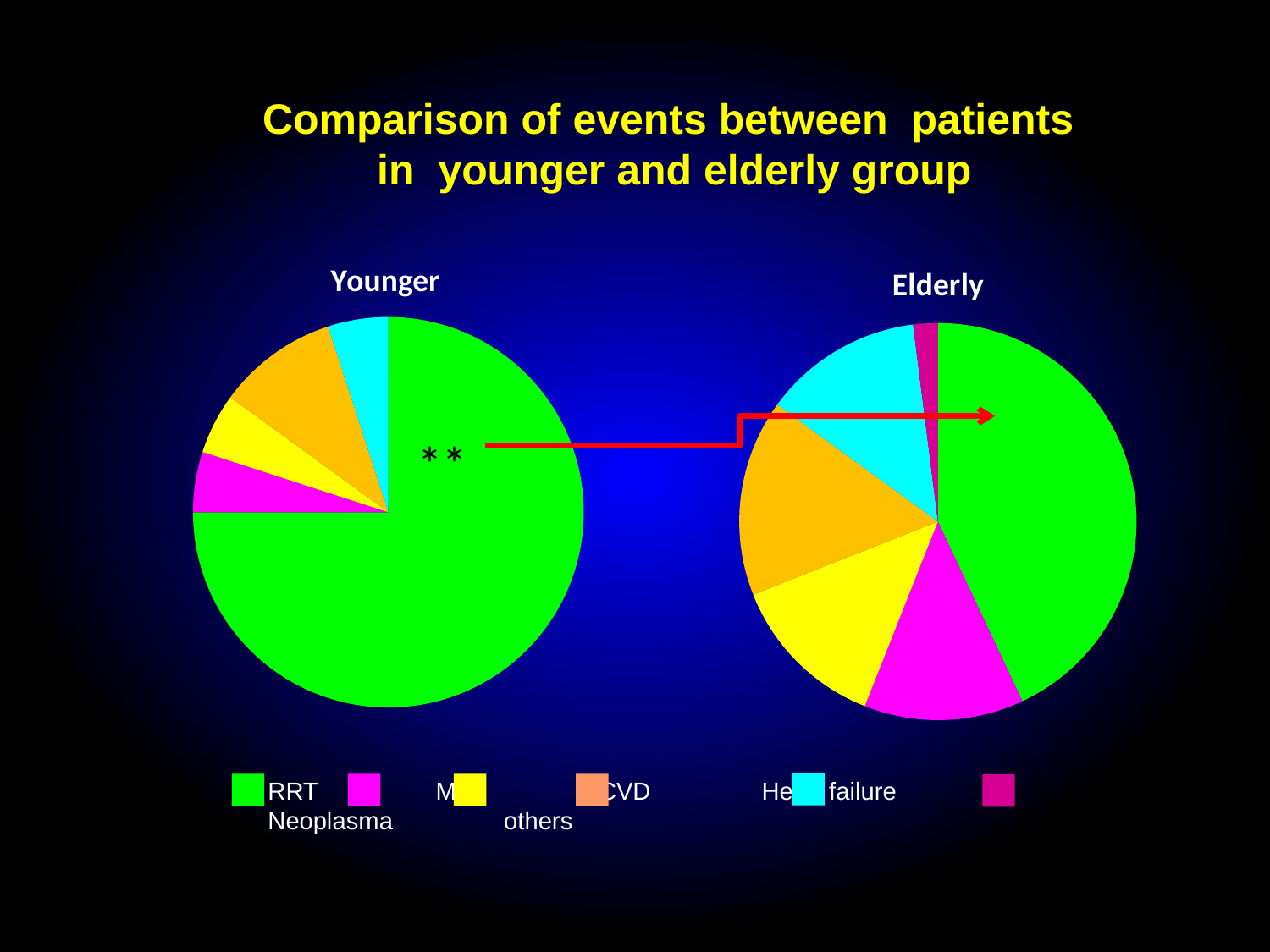
Is the RRT (green) share larger in the Younger pie chart or the Elderly pie chart? Younger In the Elderly pie chart, how many slices are there? 6 In the Younger pie chart, how many slices are there? 5 How many pie charts are shown on the slide? 2 In the Elderly pie chart, which colour slice is the smallest? Dark magenta According to the legend, which colour represents RRT? Green In the Younger pie chart, which category has the largest slice? RRT What is the title of the slide containing the two pie charts? Comparison of events between patients in younger and elderly group What kind of chart is used for the Younger group? Pie chart In the Elderly pie chart, which category has the largest slice? RRT